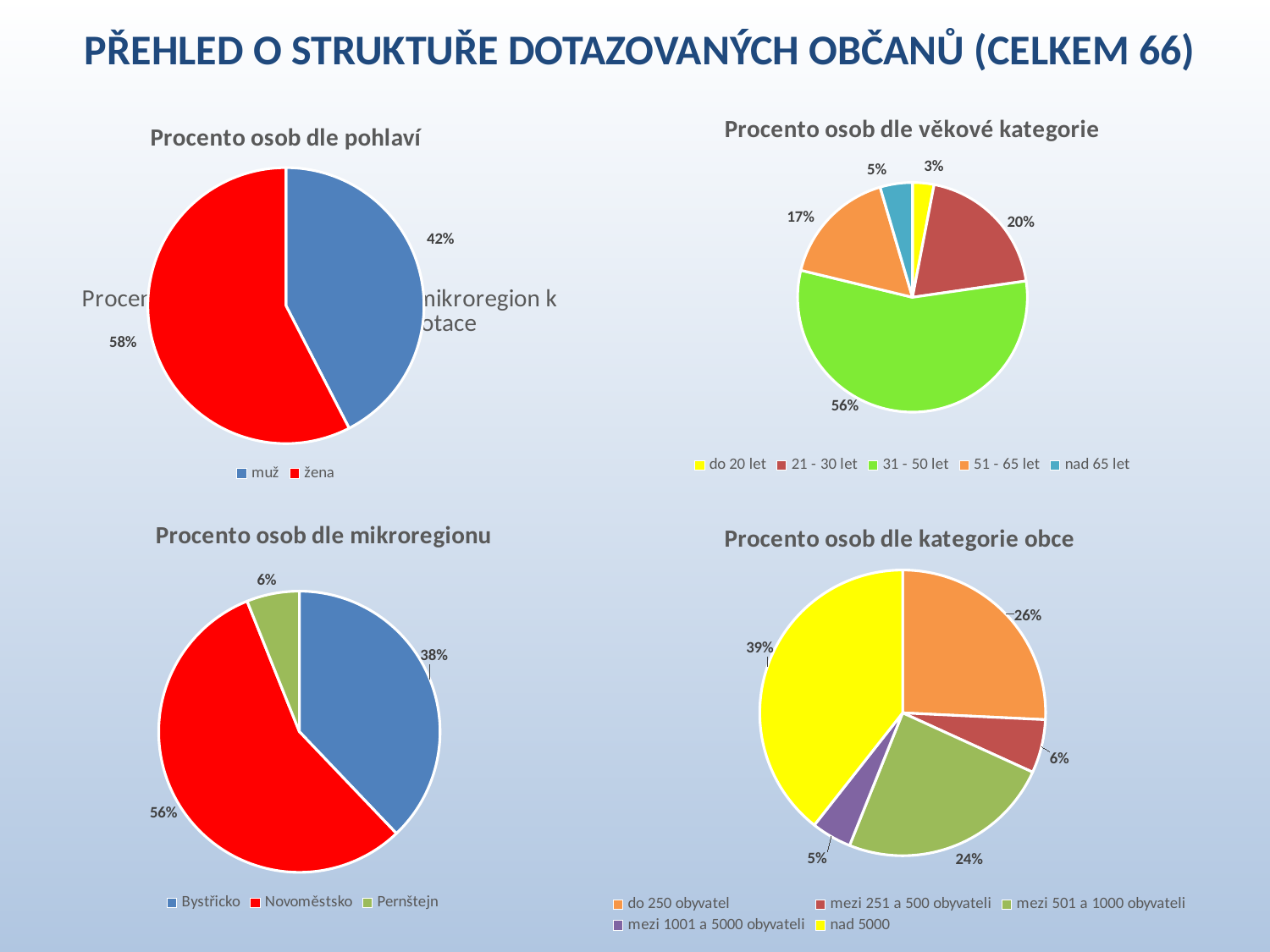
In the chart 'Procento osob dle mikroregionu', what is the share for 'Bystřicko'? 38% In the chart 'Procento osob dle pohlaví', what share of respondents are 'žena'? 58% In the chart 'Procento osob dle mikroregionu', what is the difference in percentage points between 'Novoměstsko' and 'Pernštejn'? 50 In the chart 'Procento osob dle věkové kategorie', which age category has the largest share? 31 - 50 let In the chart 'Procento osob dle kategorie obce', what is the share for 'mezi 501 a 1000 obyvateli'? 24% In the chart 'Procento osob dle věkové kategorie', which age category has the smallest share? do 20 let In the chart 'Procento osob dle kategorie obce', which category has the largest share? nad 5000 In the chart 'Procento osob dle věkové kategorie', what is the share for '51 - 65 let'? 17% In the chart 'Procento osob dle kategorie obce', which is larger: 'do 250 obyvatel' or 'mezi 251 a 500 obyvateli'? do 250 obyvatel What type of chart is 'Procento osob dle mikroregionu'? pie chart In the chart 'Procento osob dle věkové kategorie', how many age categories does the legend list? 5 In the chart 'Procento osob dle pohlaví', what share of respondents are 'muž'? 42%